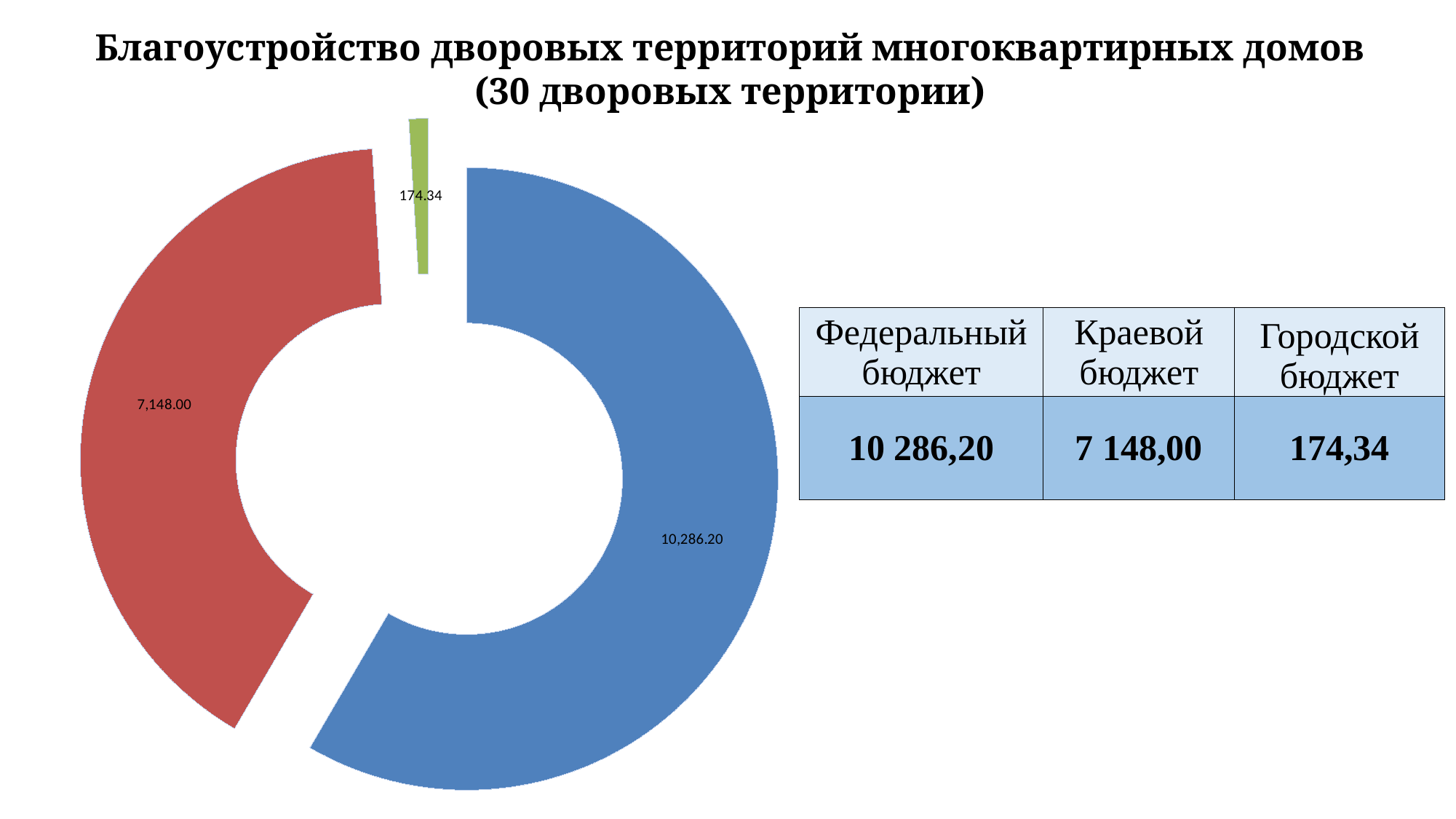
What value is labelled on the green slice of the doughnut chart? 174.34 Which budget has the largest value on the slide? Федеральный бюджет Which budget has the smallest value on the slide? Городской бюджет What value is labelled on the blue slice of the doughnut chart? 10,286.20 How many slices does the doughnut chart have? 3 According to the table, what is the value for Городской бюджет? 174,34 What is the difference between the blue slice value (10,286.20) and the red slice value (7,148.00)? 3,138.20 What type of chart is shown on the slide? doughnut chart What is the total of the three values shown in the doughnut chart? 17,608.54 According to the table, what is the value for Краевой бюджет? 7 148,00 Which is larger, the blue slice or the red slice of the doughnut chart? the blue slice What value is labelled on the red slice of the doughnut chart? 7,148.00